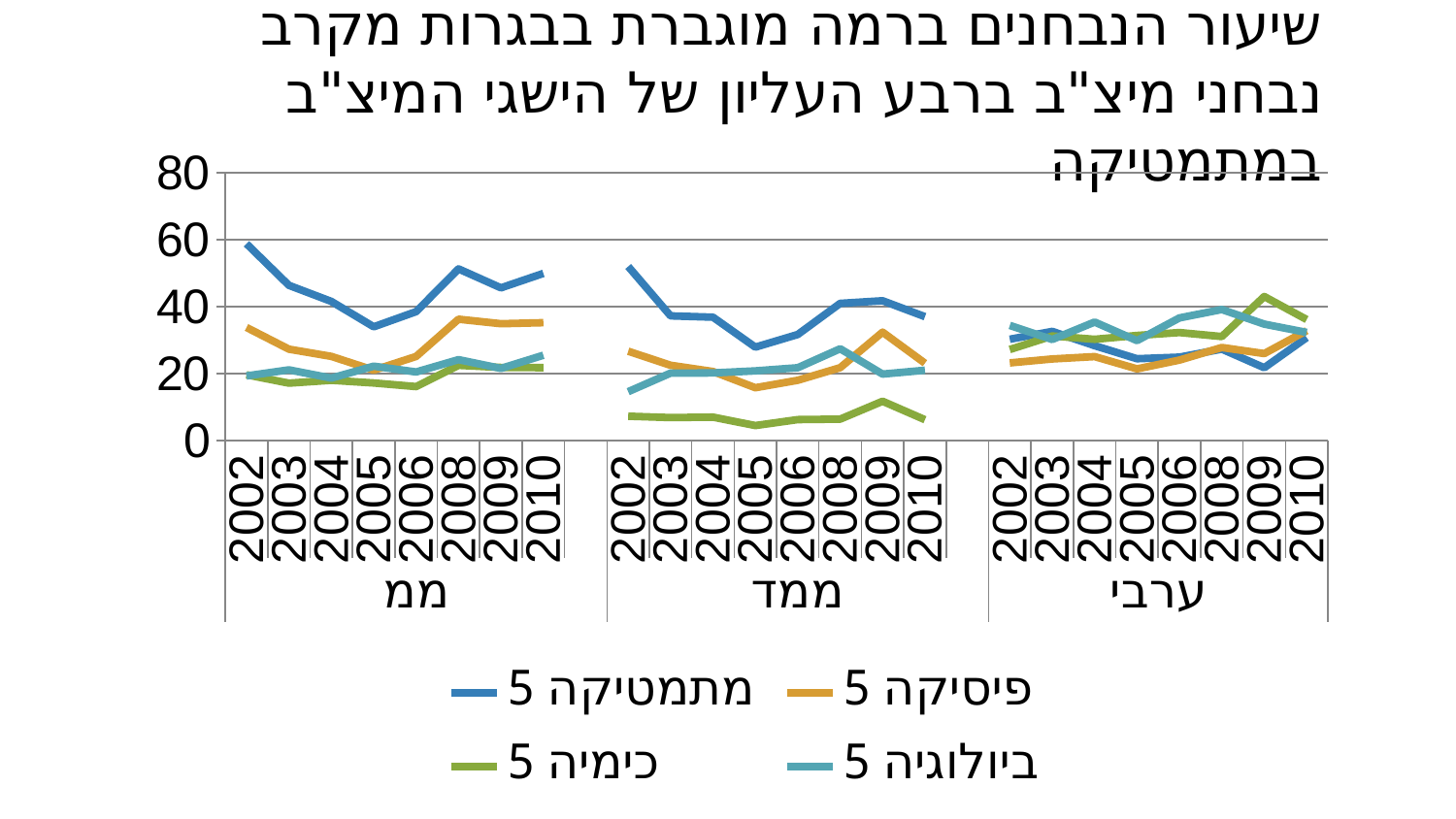
Does the מתמטיקה 5 line in the ממ group rise or fall from 2002 to 2005? fall Which series has the lowest values across the ממד group? כימיה 5 In the ממ group in 2002, which is larger: מתמטיקה 5 or פיסיקה 5? מתמטיקה 5 How many years are plotted within the ממ group on the x axis? 8 How many series does the legend list? 4 Is the value for מתמטיקה 5 in the ממ group in 2002 greater or less than 40? greater What colour is the מתמטיקה 5 line in the legend? blue Is the value for כימיה 5 in the ממד group in 2005 greater or less than 20? less What kind of chart is shown on the slide? line chart Which series has the highest value in the ממ group in 2002? מתמטיקה 5 Is the value for ביולוגיה 5 in the ערבי group in 2009 greater or less than 20? greater How many sector groups (ממ, ממד, ערבי) are shown along the x axis? 3